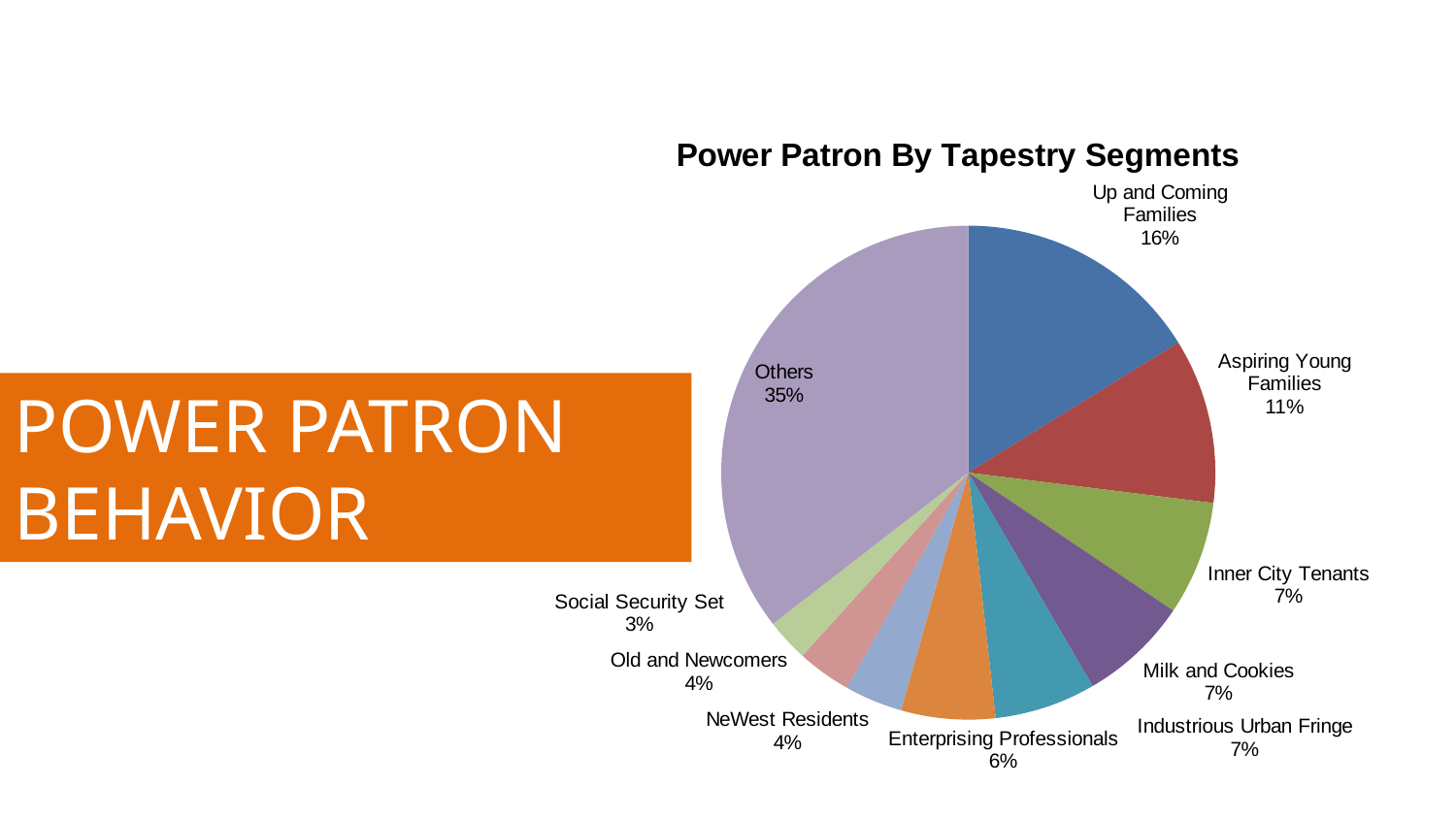
What is the title of the chart? Power Patron By Tapestry Segments What is the combined share of Milk and Cookies and Industrious Urban Fringe? 14% What share of the pie is Up and Coming Families? 16% Which segment has the largest slice of the pie? Others How many slices does the pie chart have? 10 What percentage is shown for Enterprising Professionals? 6% What percentage is shown for Aspiring Young Families? 11% What percentage is shown for Old and Newcomers? 4% Which segment has the smallest slice of the pie? Social Security Set What is the difference in percentage points between Others and Up and Coming Families? 19 What kind of chart is shown on the slide? Pie chart Which is larger, Aspiring Young Families or Inner City Tenants? Aspiring Young Families